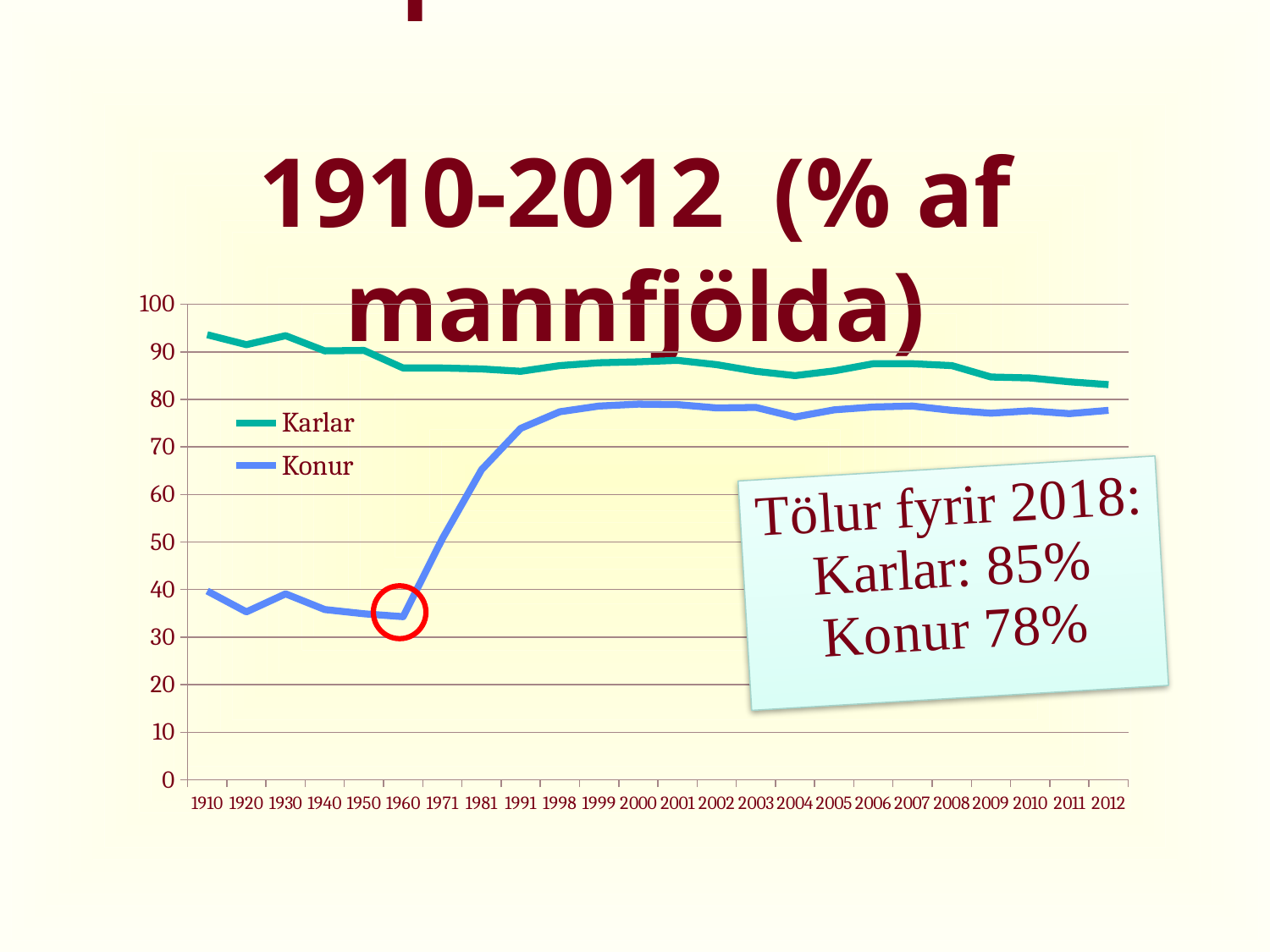
What kind of chart is shown on the slide? Line chart How many years are labelled along the x axis of the chart? 24 Which year's Konur point is highlighted with a red circle on the chart? 1960 Does the Konur line rise or fall overall from 1910 to 2012? Rises What are the two series named in the legend? Karlar and Konur In 1960, which series has the higher value, Karlar or Konur? Karlar Is the value for Konur in 1960 greater or less than 40? less Is the value for Karlar in 1910 greater or less than 90? greater Is the value for Karlar in 2012 greater or less than 90? less How many series does the chart's legend list? 2